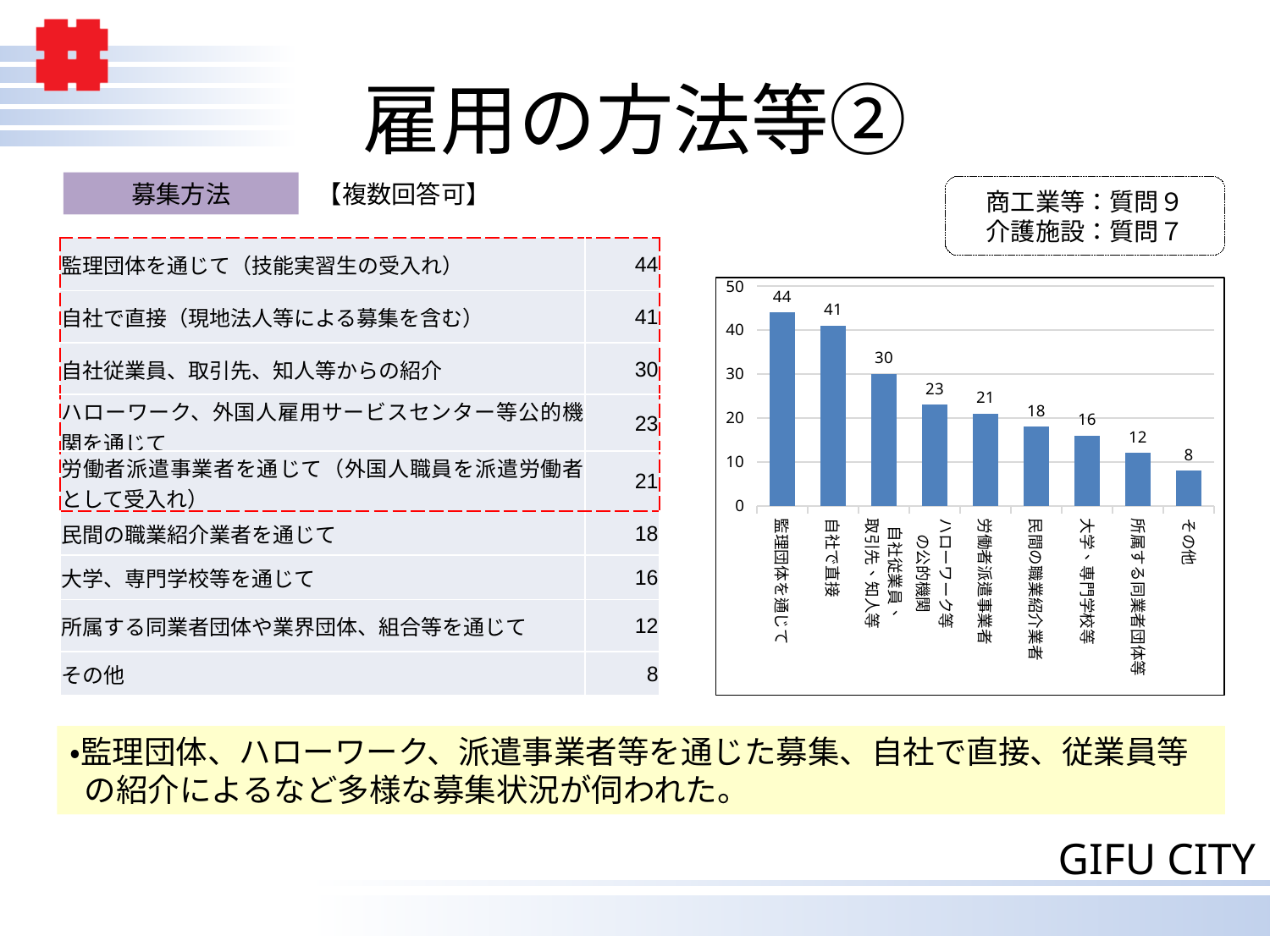
Which category has the lowest value in the chart? その他 What is the value for 監理団体を通じて in the chart? 44 How many categories (bars) does the chart show? 9 What is the value for 大学、専門学校等 in the chart? 16 Which is larger, the value for 労働者派遣事業者 or the value for 民間の職業紹介業者? 労働者派遣事業者 What is the difference between the values for 自社従業員、取引先、知人等 and 所属する同業者団体等? 18 Which category has the highest value in the chart? 監理団体を通じて What type of chart is shown on the slide? bar chart What is the value for ハローワーク等の公的機関 in the chart? 23 Do the values rise or fall from left to right along the x axis? fall What is the difference between the values for 監理団体を通じて and 自社で直接? 3 What is the value for 自社で直接 in the chart? 41